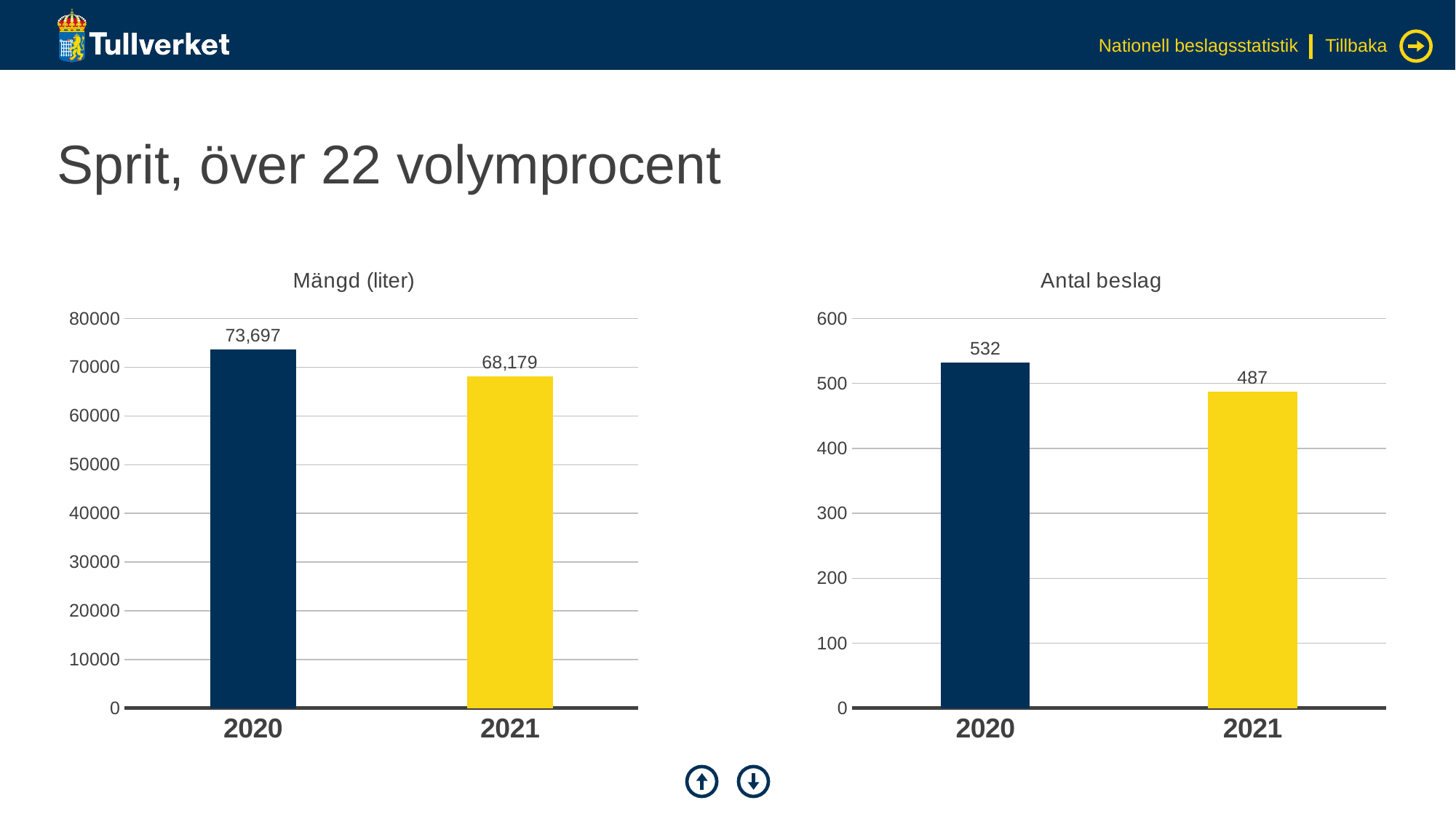
In the 'Mängd (liter)' chart, what is the value for 2021? 68,179 In the 'Antal beslag' chart, what is the value for 2020? 532 In the 'Mängd (liter)' chart, which year has the highest value? 2020 What kind of chart is the 'Antal beslag' chart? bar chart In the 'Antal beslag' chart, what is the value for 2021? 487 In the 'Mängd (liter)' chart, what is the difference between the 2020 and 2021 values? 5,518 In the 'Mängd (liter)' chart, what is the value for 2020? 73,697 How many years are shown in the 'Mängd (liter)' chart? 2 In the 'Antal beslag' chart, is the value for 2021 greater or less than 500? less In the 'Mängd (liter)' chart, do the values rise or fall from 2020 to 2021? fall In the 'Antal beslag' chart, which year has the lowest value? 2021 In the 'Antal beslag' chart, what is the difference between the 2020 and 2021 values? 45